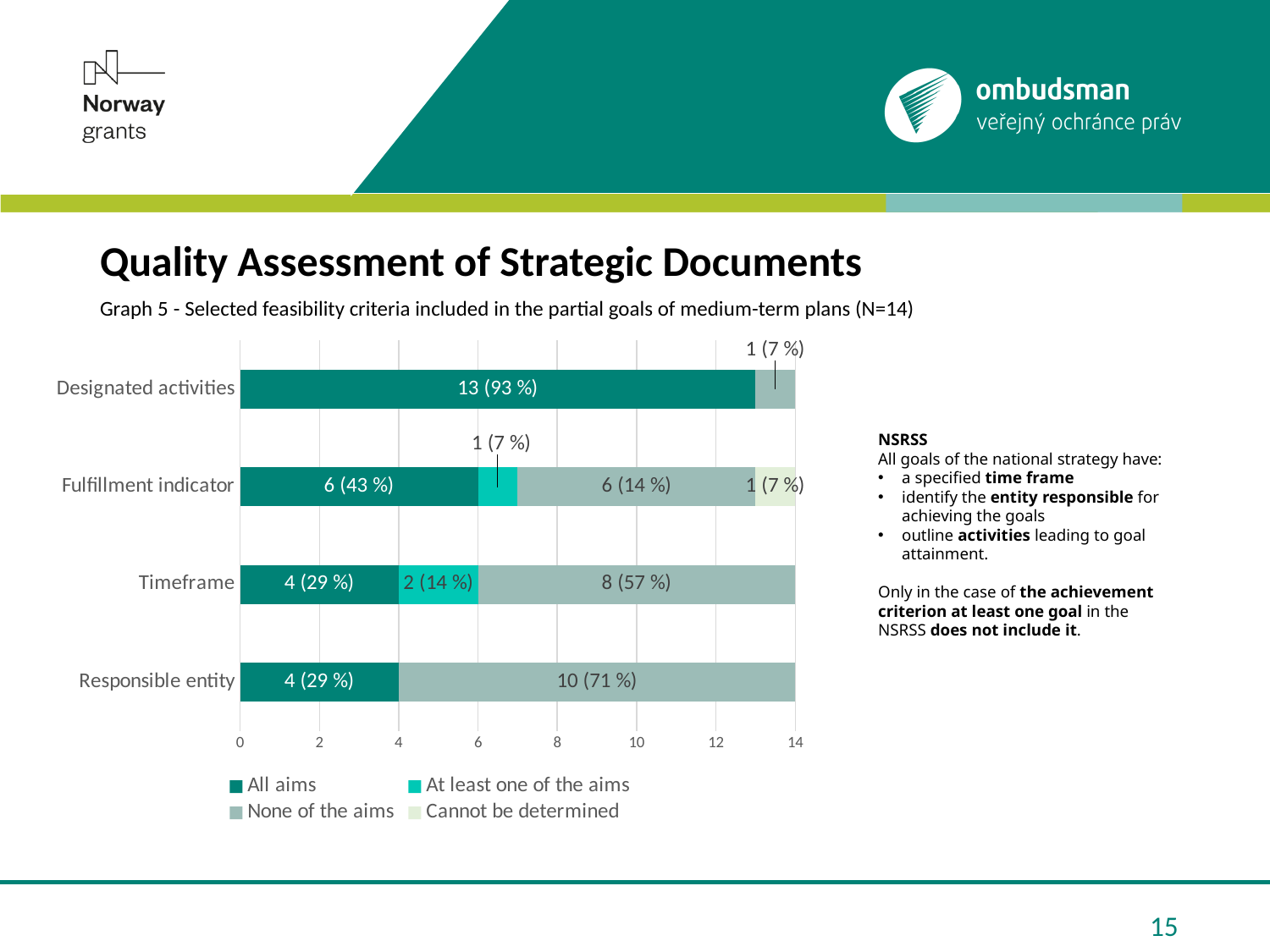
What is the 'At least one of the aims' value for Timeframe? 2 (14 %) Which category has the highest 'None of the aims' value? Responsible entity How many categories are shown on the vertical axis of the chart? 4 What is the 'Cannot be determined' value for Fulfillment indicator? 1 (7 %) What is the total of the stacked bar for Timeframe? 14 What is the 'None of the aims' value for Responsible entity? 10 (71 %) What kind of chart is shown on the slide? Stacked bar chart How many series does the chart legend list? 4 Which category has the highest 'All aims' value? Designated activities Which is larger: the 'None of the aims' count for Timeframe or the 'None of the aims' count for Responsible entity? Responsible entity What is the 'All aims' value for Designated activities? 13 (93 %) What is the difference between the 'All aims' count for Designated activities and the 'All aims' count for Fulfillment indicator? 7